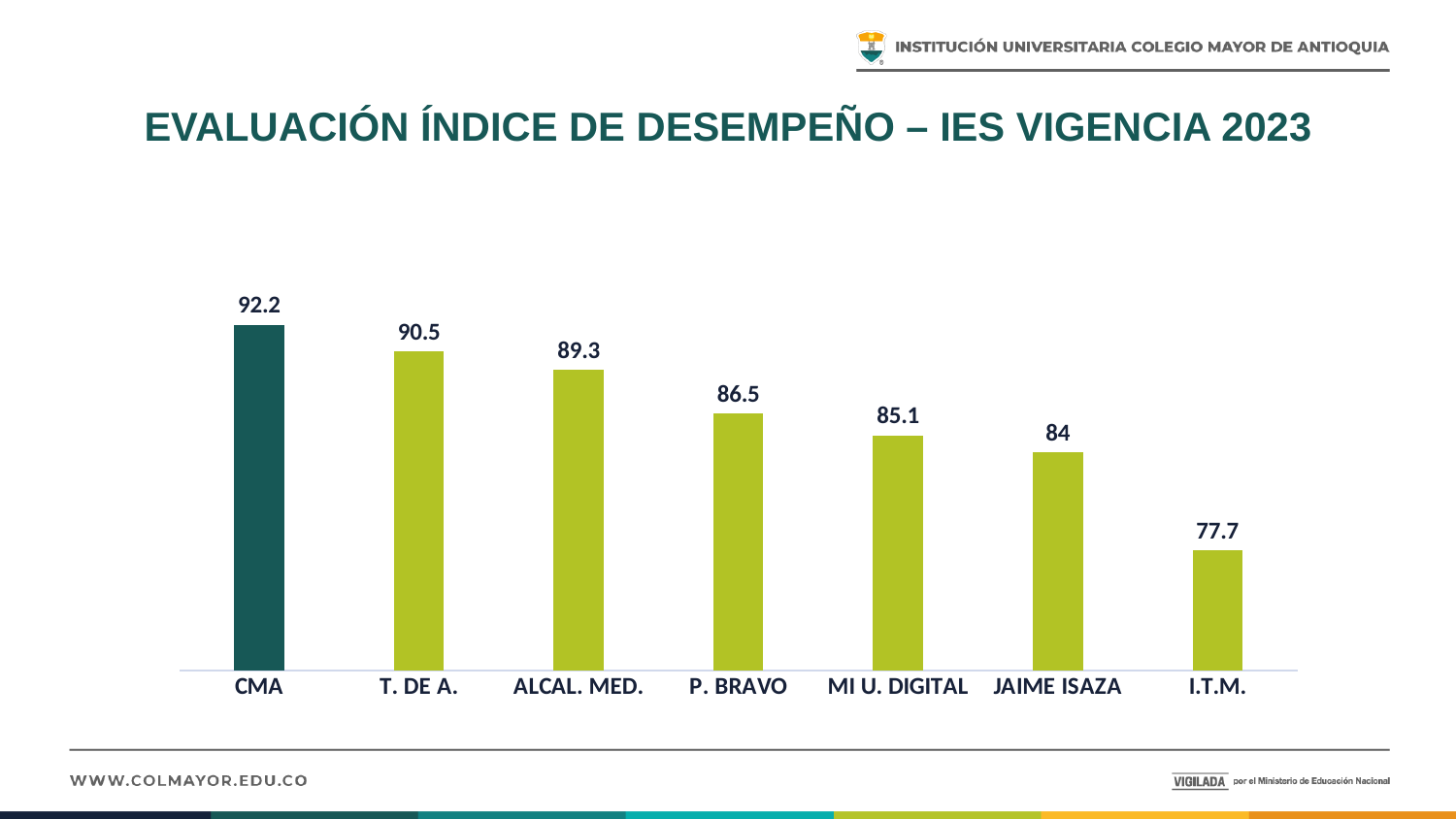
What is the difference between the values for CMA and T. DE A.? 1.7 Which category has the lowest value? I.T.M. What is the value for P. BRAVO? 86.5 What is the value for CMA? 92.2 Which is larger, the value for MI U. DIGITAL or the value for JAIME ISAZA? MI U. DIGITAL What is the value for JAIME ISAZA? 84 Which category has the highest value? CMA What is the value for I.T.M.? 77.7 Do the values rise or fall from left to right along the x axis? Fall What kind of chart is shown on the slide? Bar chart What is the difference between the values for ALCAL. MED. and I.T.M.? 11.6 How many categories are shown in the chart? 7